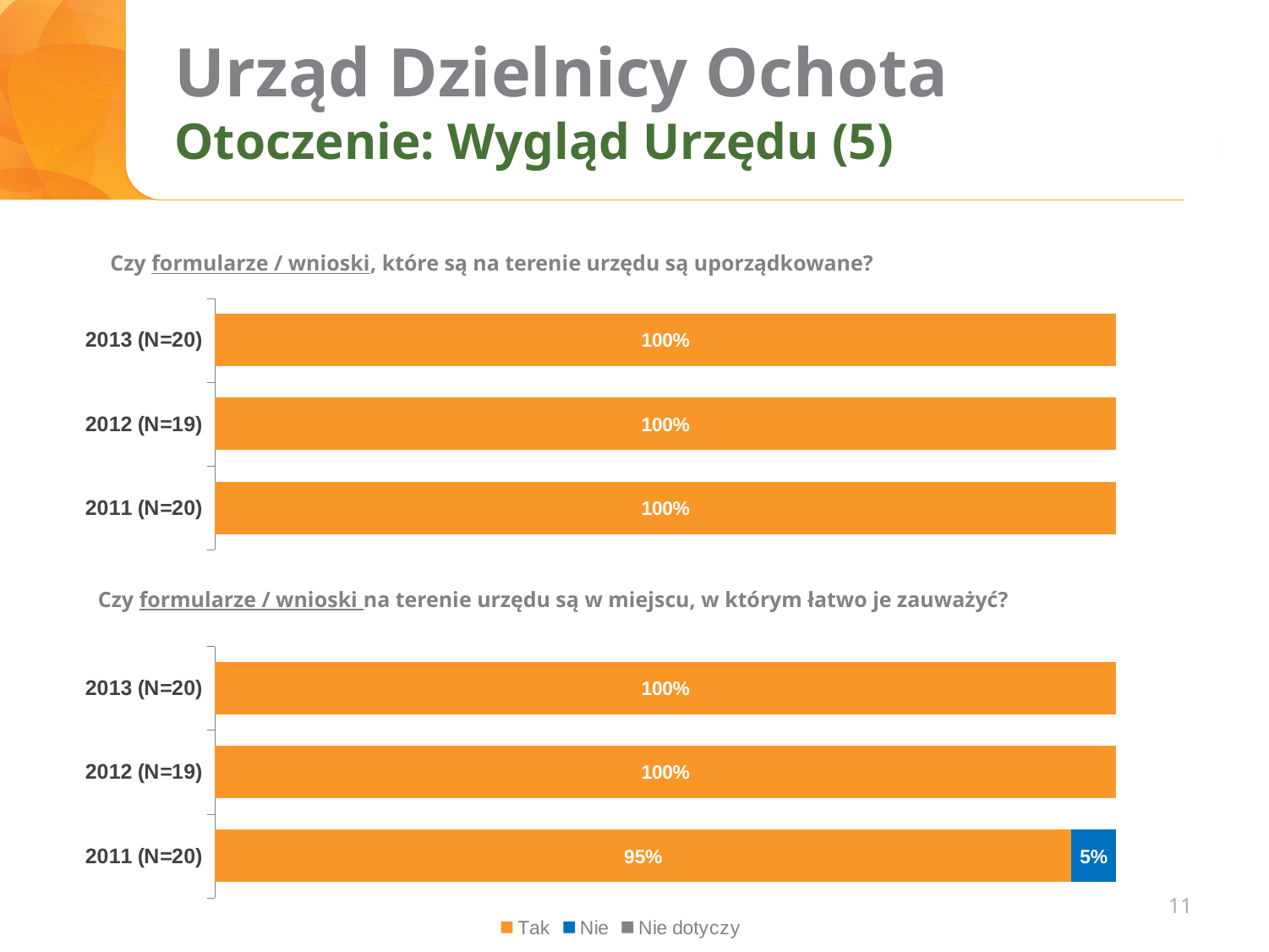
In the bottom chart ("Czy formularze / wnioski na terenie urzędu są w miejscu, w którym łatwo je zauważyć?"), what is the total of the stacked bar for 2011 (N=20)? 100% How many series does the legend at the bottom of the slide list? 3 Which legend entry is shown in blue? Nie What kind of chart is the top chart ("Czy formularze / wnioski, które są na terenie urzędu są uporządkowane?")? Bar chart In the bottom chart ("Czy formularze / wnioski na terenie urzędu są w miejscu, w którym łatwo je zauważyć?"), what is the value for "Nie" in 2011 (N=20)? 5% In the bottom chart ("Czy formularze / wnioski na terenie urzędu są w miejscu, w którym łatwo je zauważyć?"), what is the value for "Tak" in 2011 (N=20)? 95% In the bottom chart ("Czy formularze / wnioski na terenie urzędu są w miejscu, w którym łatwo je zauważyć?"), what is the difference between the "Tak" values for 2012 (N=19) and 2011 (N=20)? 5% In the bottom chart ("Czy formularze / wnioski na terenie urzędu są w miejscu, w którym łatwo je zauważyć?"), which is larger for 2011 (N=20): "Tak" or "Nie"? Tak In the bottom chart ("Czy formularze / wnioski na terenie urzędu są w miejscu, w którym łatwo je zauważyć?"), which year has the lowest "Tak" value? 2011 (N=20) In the bottom chart ("Czy formularze / wnioski na terenie urzędu są w miejscu, w którym łatwo je zauważyć?"), what is the value for "Tak" in 2013 (N=20)? 100% How many year categories does the top chart ("Czy formularze / wnioski, które są na terenie urzędu są uporządkowane?") show? 3 In the top chart ("Czy formularze / wnioski, które są na terenie urzędu są uporządkowane?"), what is the value for "Tak" in 2012 (N=19)? 100%